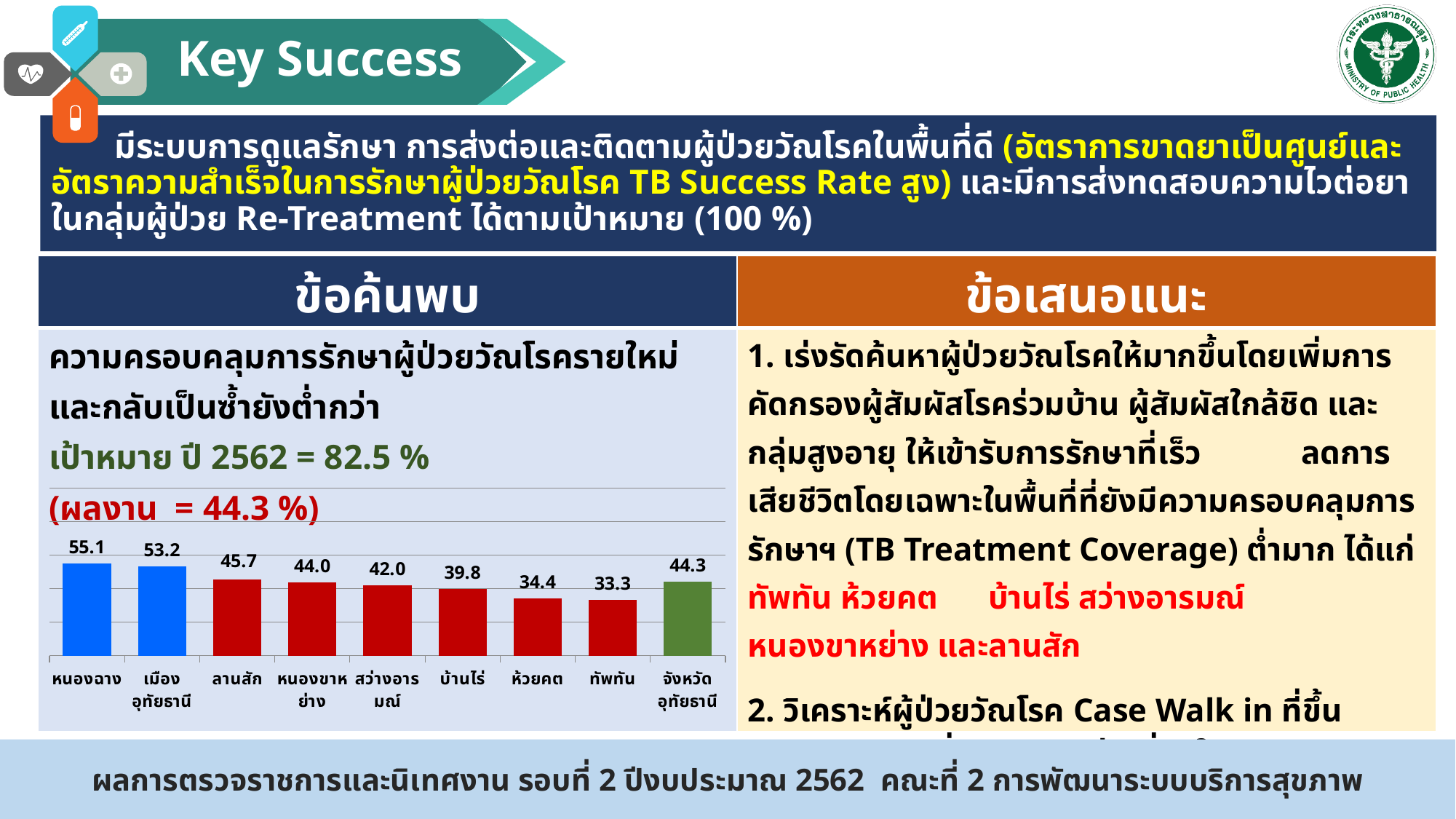
What is the value for หนองฉาง? 55.1 How many categories are shown in the chart? 9 What colour is the bar for จังหวัดอุทัยธานี? green What is the value for จังหวัดอุทัยธานี? 44.3 Which category has the lowest value? ทัพทัน Which category has the highest value? หนองฉาง Which is larger, the value for ลานสัก or the value for สว่างอารมณ์? ลานสัก What is the value for ทัพทัน? 33.3 What is the difference between the values for หนองฉาง and ทัพทัน? 21.8 What kind of chart is shown on the slide? bar chart What is the difference between the values for เมืองอุทัยธานี and จังหวัดอุทัยธานี? 8.9 What is the value for บ้านไร่? 39.8